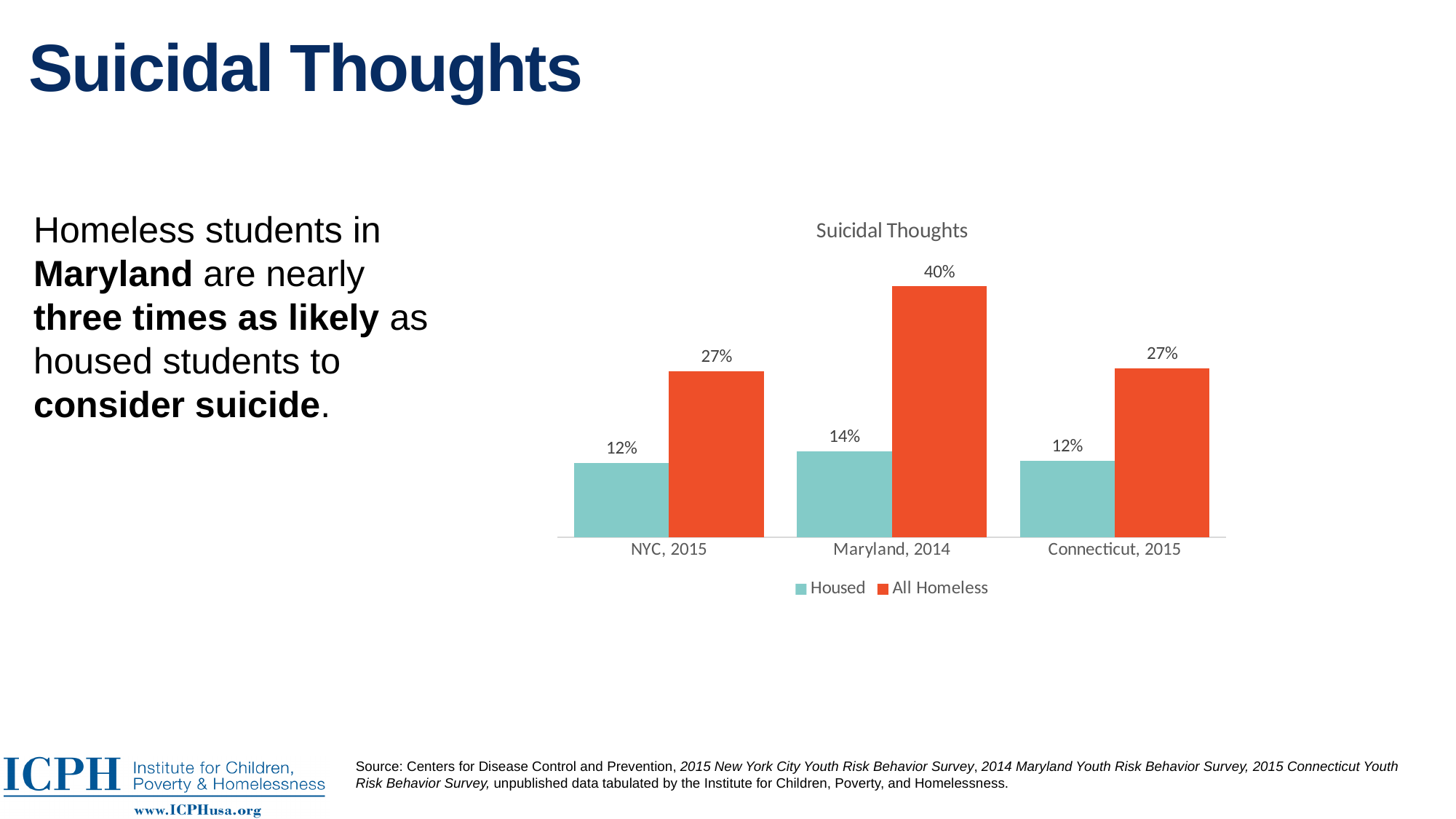
How many series does the legend list? 2 What is the value for All Homeless in Connecticut, 2015? 27% What is the value for All Homeless in Maryland, 2014? 40% Which category has the highest All Homeless value? Maryland, 2014 What is the value for Housed in NYC, 2015? 12% What is the difference between the All Homeless and Housed values for NYC, 2015? 15% What kind of chart is shown on the slide? Bar chart What is the difference between the All Homeless and Housed values for Maryland, 2014? 26% What is the value for Housed in Maryland, 2014? 14% Which is larger in Connecticut, 2015: the Housed value or the All Homeless value? All Homeless How many categories are shown on the x axis? 3 Which category has the highest Housed value? Maryland, 2014